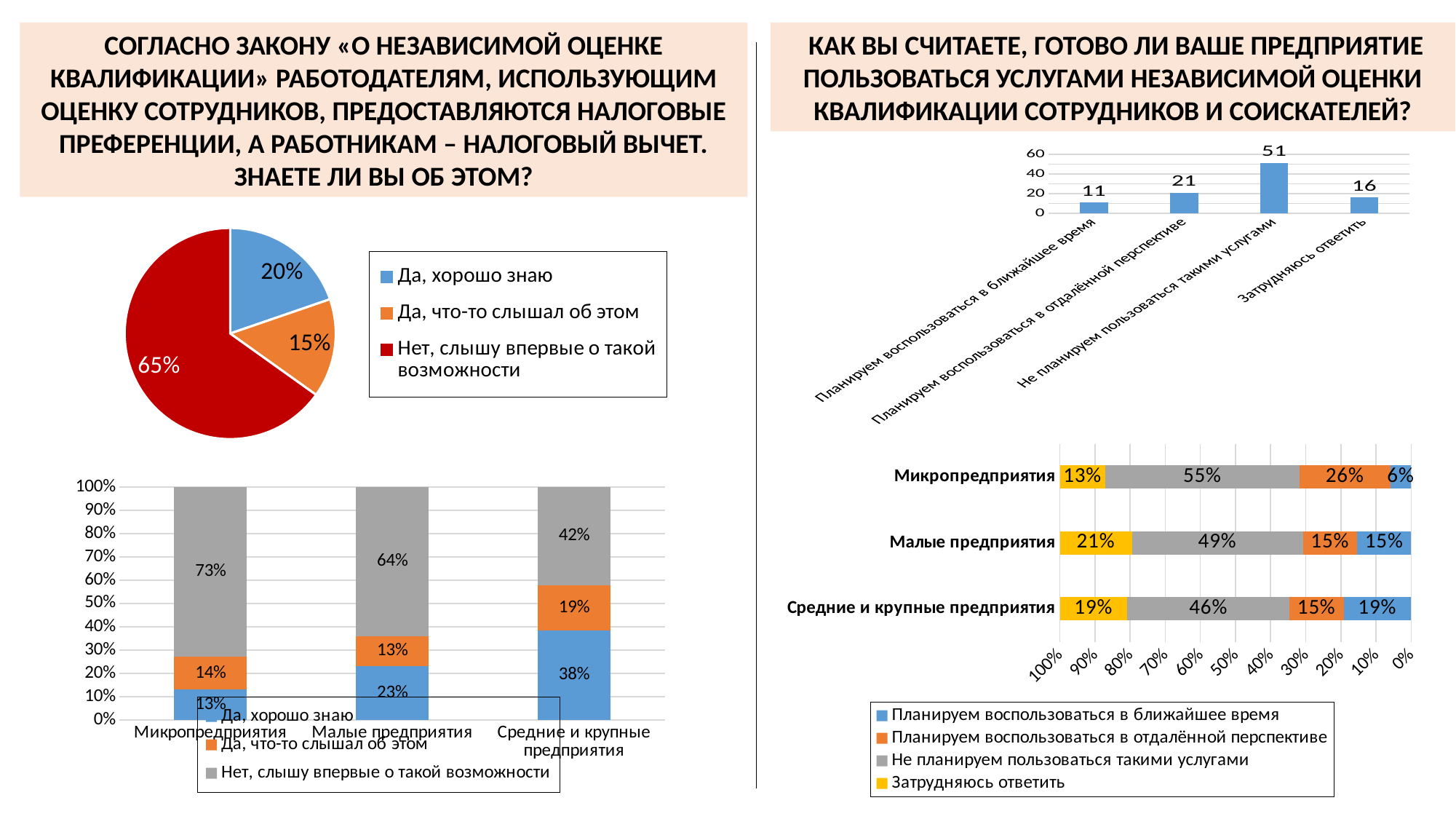
In the stacked bar chart at the bottom left of the slide, what is the value of «Да, хорошо знаю» for Средние и крупные предприятия? 38% In the bar chart at the top right of the slide, which category has the lowest value? Планируем воспользоваться в ближайшее время In the horizontal stacked bar chart at the bottom right of the slide, which is larger: «Планируем воспользоваться в ближайшее время» for Микропредприятия or for Средние и крупные предприятия? Средние и крупные предприятия What type of chart is shown at the bottom right of the slide? Stacked bar chart In the horizontal stacked bar chart at the bottom right of the slide, what is the value of «Затрудняюсь ответить» for Малые предприятия? 21% In the pie chart on the left side of the slide, which category has the smallest slice? Да, что-то слышал об этом In the bar chart at the top right of the slide, what is the value for «Не планируем пользоваться такими услугами»? 51 How many bars are there in the bar chart at the top right of the slide? 4 In the stacked bar chart at the bottom left of the slide, what is the value of «Нет, слышу впервые о такой возможности» for Микропредприятия? 73% How many entries does the legend of the pie chart on the left side of the slide list? 3 In the stacked bar chart at the bottom left of the slide, what is the difference between the «Нет, слышу впервые о такой возможности» values for Микропредприятия and Малые предприятия? 9% In the pie chart on the left side of the slide, what share is labelled for «Нет, слышу впервые о такой возможности»? 65%